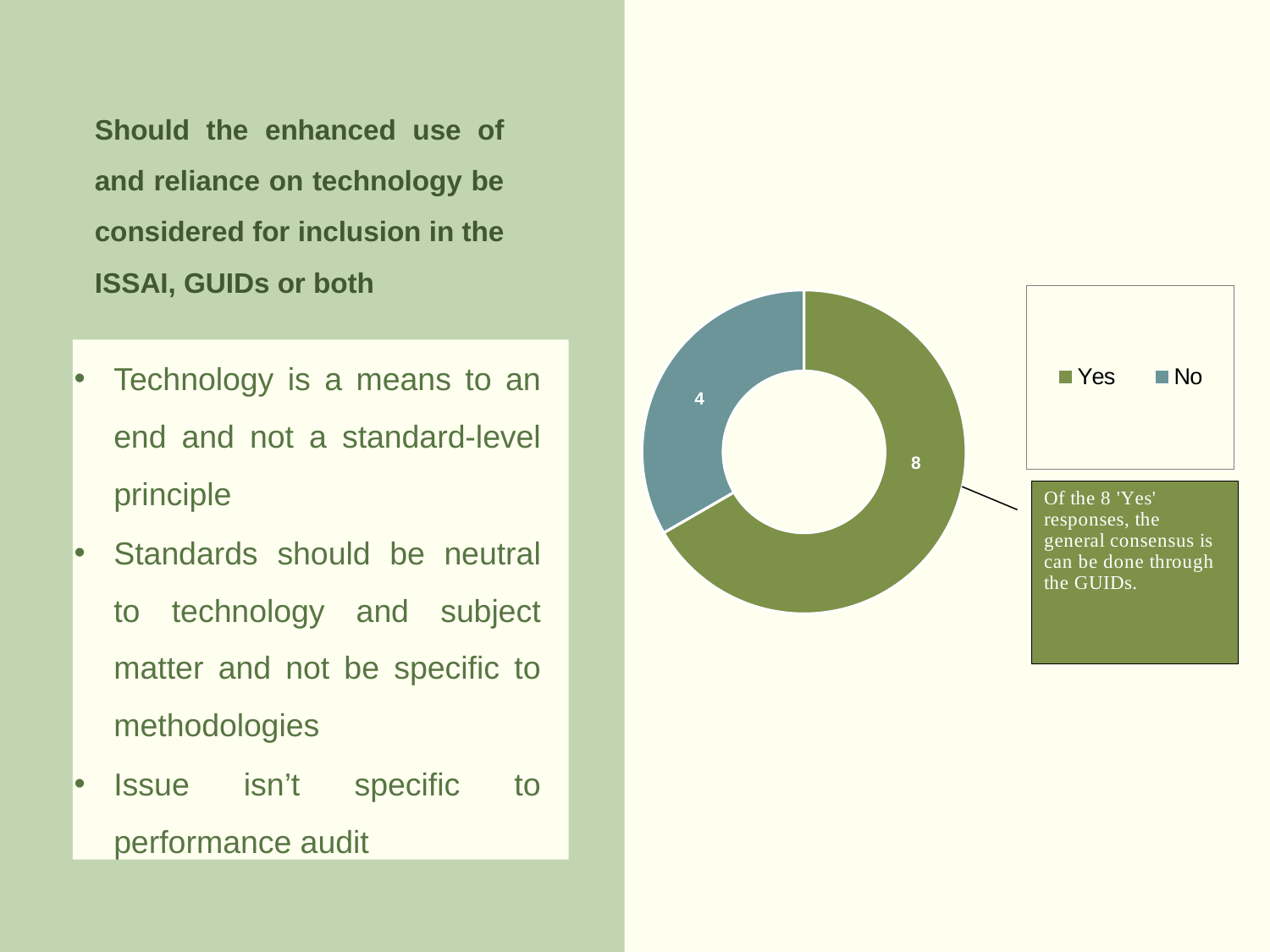
How many categories does the chart show? 2 What is the value for No? 4 Which category has the highest value? Yes Which category has the lowest value? No How many entries does the legend list? 2 Which is larger, the value for Yes or the value for No? Yes What is the difference between the Yes and No values? 4 What colour is the No segment? Blue-grey What kind of chart is shown on the slide? Doughnut chart What colour is the Yes segment? Green What is the value for Yes? 8 What is the total of all values in the chart? 12